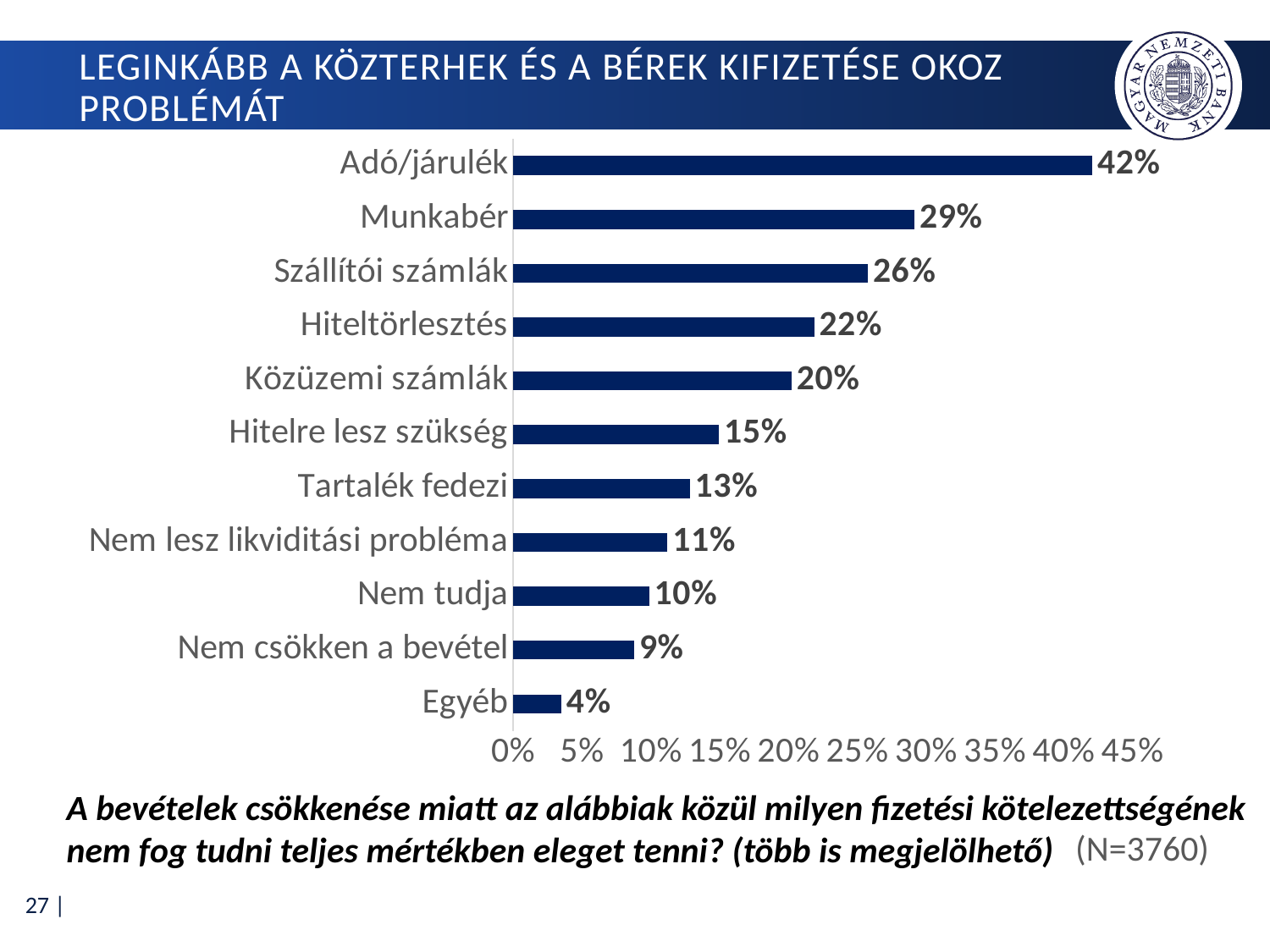
What is the value for Nem csökken a bevétel? 9% Is the value for Munkabér greater or less than 25%? greater Which category has the lowest value? Egyéb What is the value for Adó/járulék? 42% What is the difference between the values for Hiteltörlesztés and Tartalék fedezi? 9% Which category has the highest value? Adó/járulék What is the difference between the values for Adó/járulék and Munkabér? 13% How many categories are shown in the chart? 11 What kind of chart is shown on the slide? bar chart What is the sample size (N) stated below the chart? N=3760 Which is larger, the value for Szállítói számlák or the value for Hitelre lesz szükség? Szállítói számlák What is the value for Közüzemi számlák? 20%